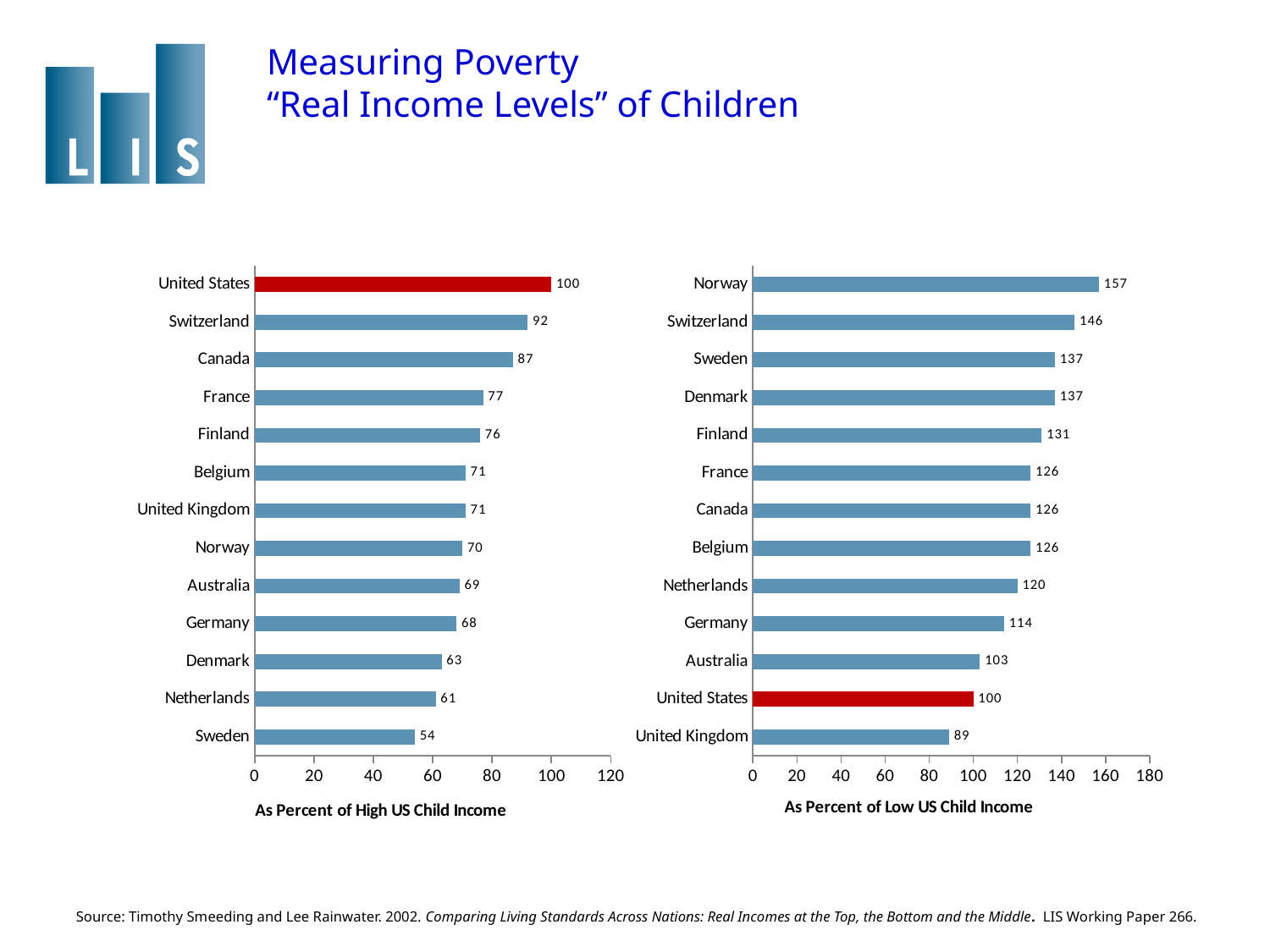
In the right chart (As Percent of Low US Child Income), which country has the lowest value? United Kingdom How many countries are shown in the left chart (As Percent of High US Child Income)? 13 In the right chart (As Percent of Low US Child Income), which is larger, the value for Australia or the value for Germany? Germany In the left chart (As Percent of High US Child Income), which is larger, the value for France or the value for Germany? France In the right chart (As Percent of Low US Child Income), which country has the highest value? Norway What type of chart is used on this slide? Bar chart In the right chart (As Percent of Low US Child Income), which country's bar is coloured red? United States In the right chart (As Percent of Low US Child Income), what is the difference between the values for Norway and the United States? 57 In the right chart (As Percent of Low US Child Income), what is the value for Netherlands? 120 In the left chart (As Percent of High US Child Income), what is the difference between the values for Switzerland and Sweden? 38 In the left chart (As Percent of High US Child Income), which country has the lowest value? Sweden In the left chart (As Percent of High US Child Income), what is the value for Canada? 87